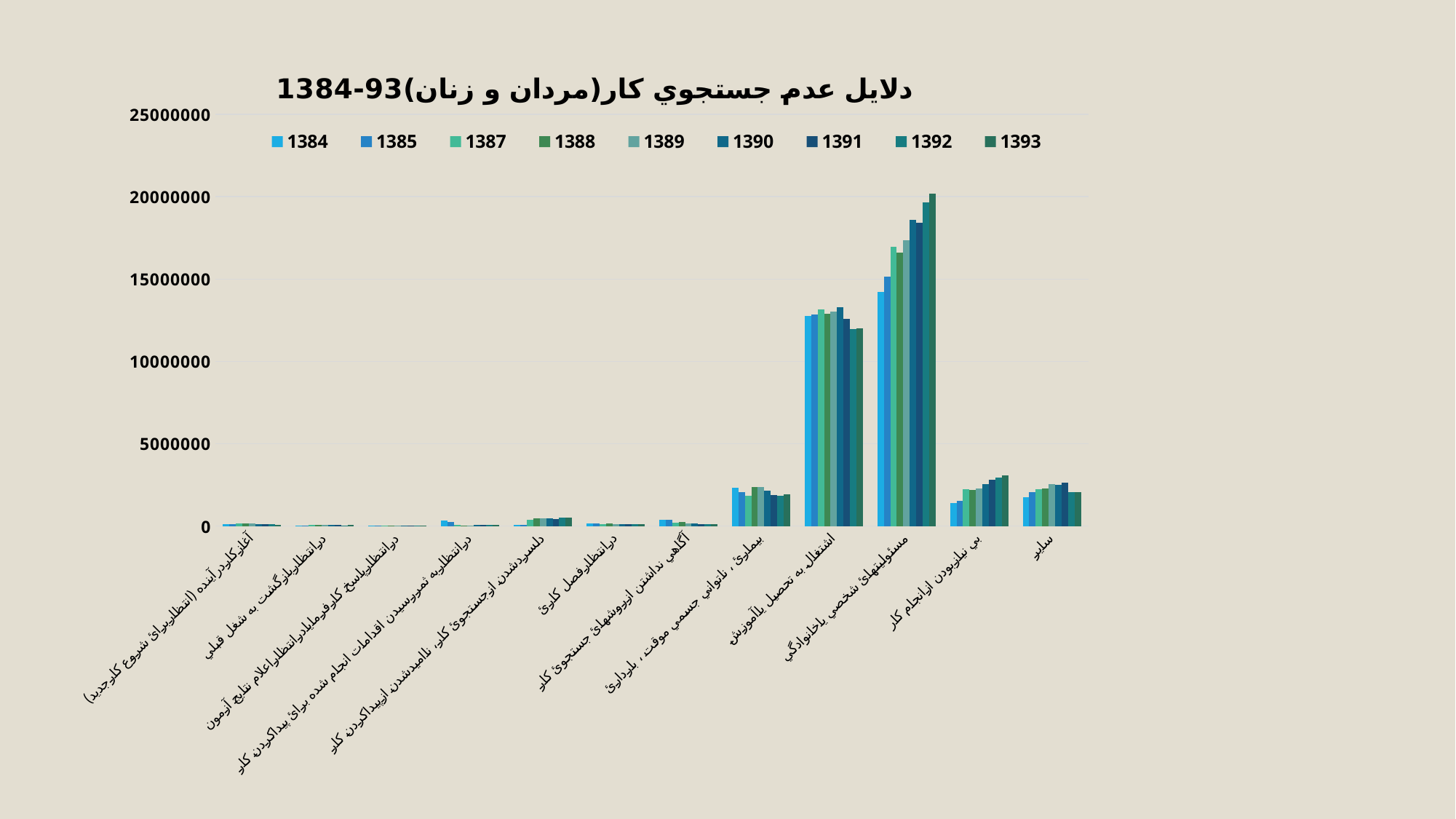
Which category has the highest bars overall? مسئولیتهای شخصی یاخانوادگی Is the value for 1384 in the category اشتغال به تحصیل یاآموزش greater or less than 10000000? greater How many series does the legend list? 9 What is the title of the chart? دلايل عدم جستجوي كار(مردان و زنان)93-1384 Is the value for 1393 in the category بی نیازبودن ازانجام کار greater or less than 5000000? less Is the value for 1393 in the category مسئولیتهای شخصی یاخانوادگی greater or less than 15000000? greater For 1393, which is larger: اشتغال به تحصیل یاآموزش or مسئولیتهای شخصی یاخانوادگی? مسئولیتهای شخصی یاخانوادگی For the category مسئولیتهای شخصی یاخانوادگی, do the values rise or fall from 1384 to 1393? rise How many categories are shown along the x axis? 12 What kind of chart is shown on the slide? bar chart